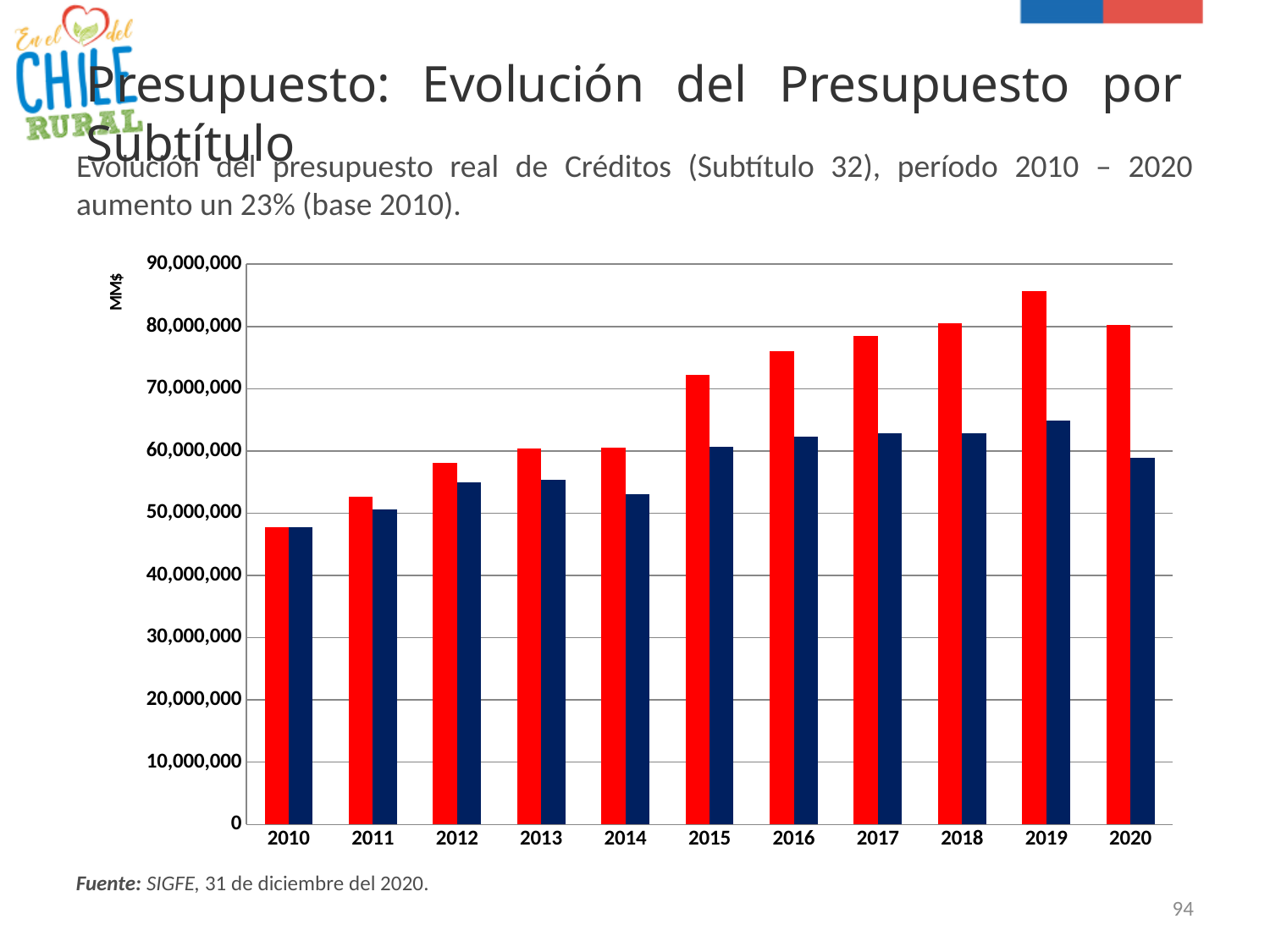
Is the value of the dark blue bar for 2014 greater or less than 50,000,000? greater Do the red bars generally rise or fall from 2010 to 2019? rise How many years are shown on the x axis of the chart? 11 In which year is the red bar the shortest? 2010 What label is shown on the vertical axis of the chart? MM$ Is the value of the dark blue bar for 2020 greater or less than 60,000,000? less In which year is the red bar the tallest? 2019 Is the value of the red bar for 2019 greater or less than 80,000,000? greater For 2016, which bar is taller, the red bar or the dark blue bar? the red bar What kind of chart is shown on the slide? bar chart In which year is the dark blue bar the tallest? 2019